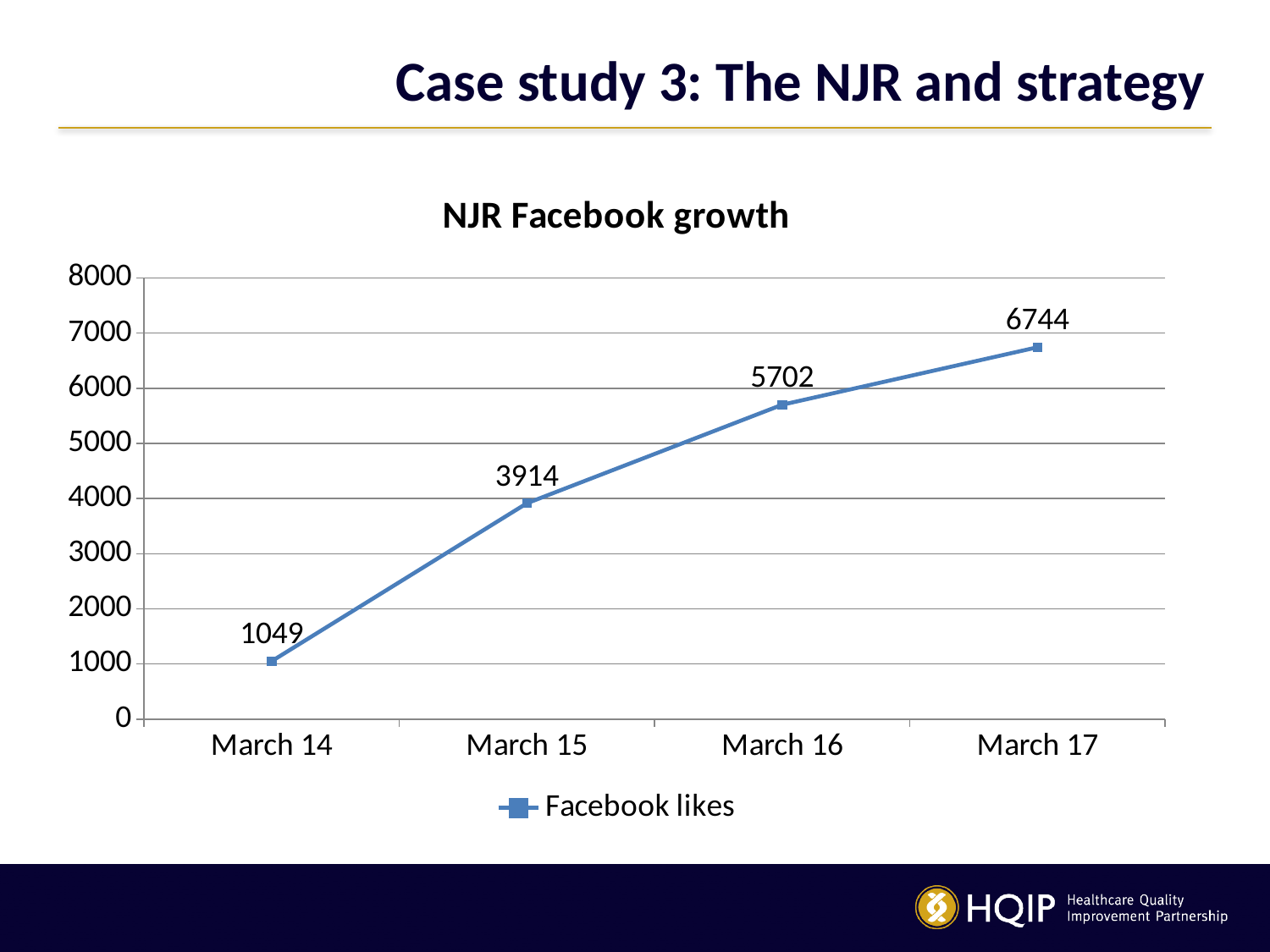
What is the value for Facebook likes in March 14? 1049 Which point has the highest number of Facebook likes? March 17 What is the value for Facebook likes in March 16? 5702 How many data points are plotted on the chart? 4 Which point has the lowest number of Facebook likes? March 14 Do the values rise or fall from March 14 to March 17? rise Which is larger, the value for March 15 or the value for March 16? March 16 What is the difference in Facebook likes between March 15 and March 14? 2865 Is the value for March 15 greater or less than 4000? less What is the value for Facebook likes in March 17? 6744 What kind of chart is shown on the slide? line chart What is the difference in Facebook likes between March 17 and March 16? 1042